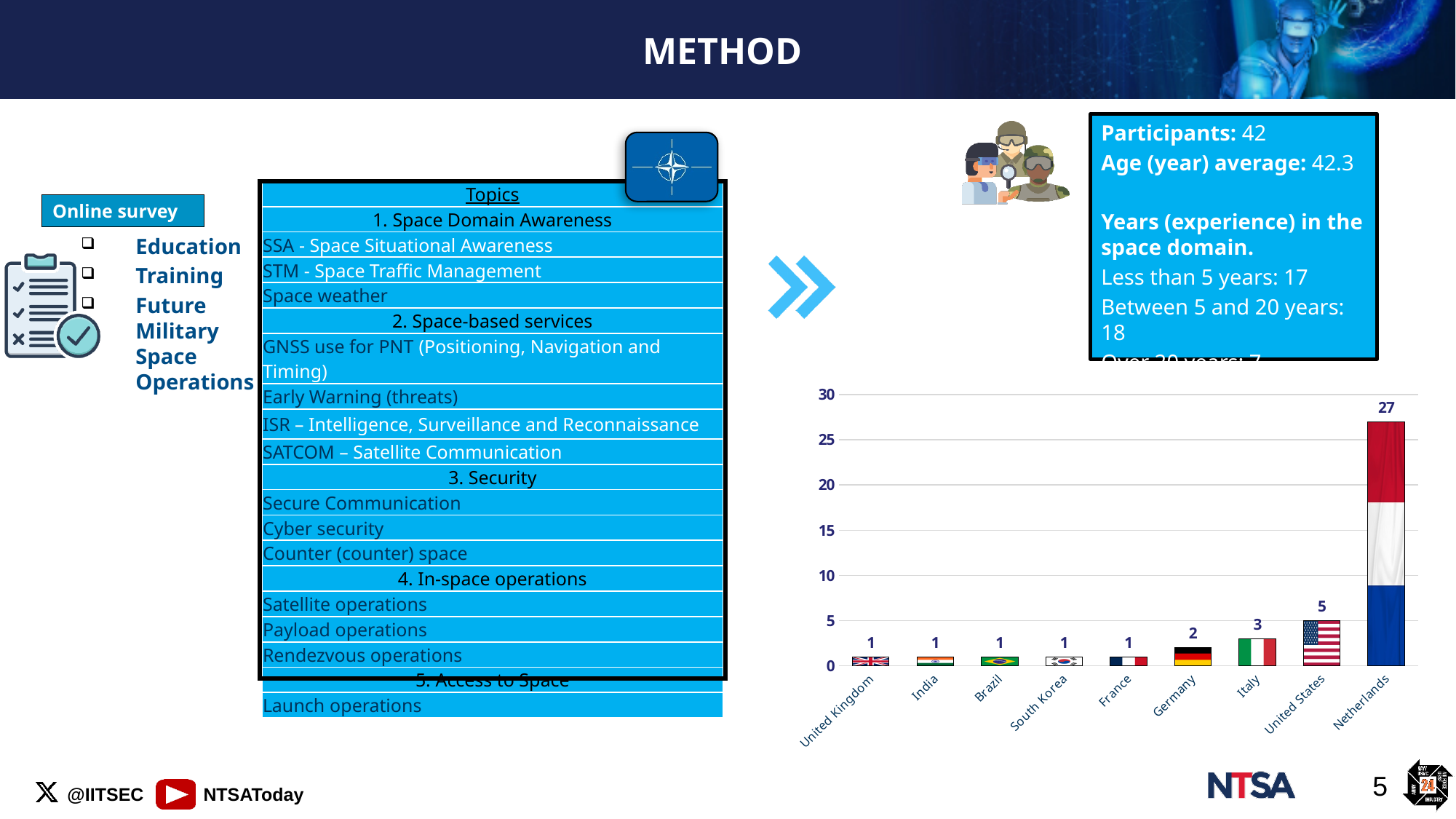
What kind of chart is shown on the slide? bar chart Is the value for Netherlands greater or less than 25? greater Do the values in the bar chart rise or fall from left to right? rise Which country has the highest value in the bar chart? Netherlands What is the difference between the values for Netherlands and United States? 22 What is the value for Italy in the bar chart? 3 Which has a larger value, Italy or Germany? Italy How many countries are shown in the bar chart? 9 What is the value for United States in the bar chart? 5 What is the value for Netherlands in the bar chart? 27 What is the value for Germany in the bar chart? 2 What is the value for France in the bar chart? 1